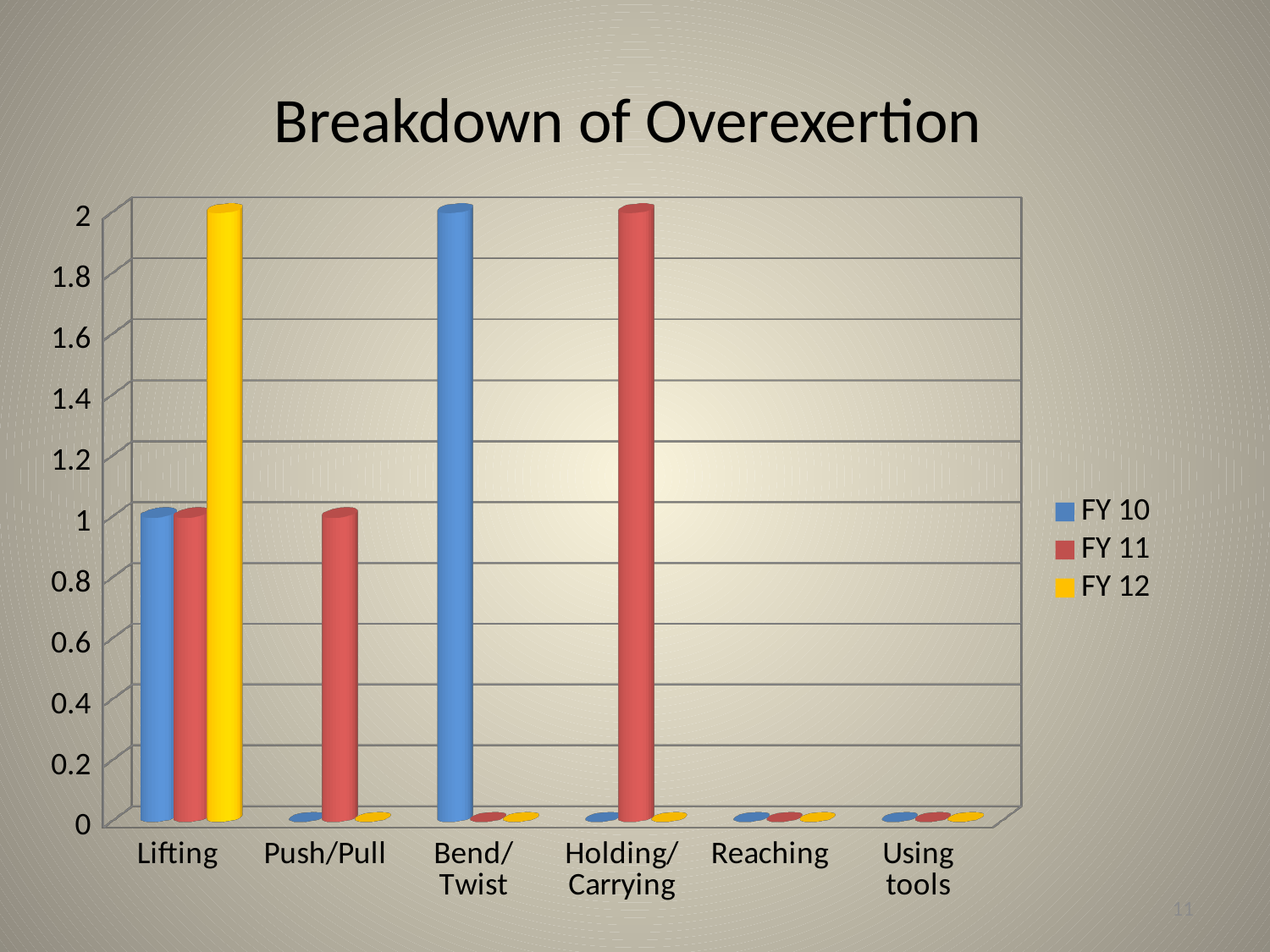
How many categories are shown on the x axis? 6 Which is larger, the FY 11 value for Holding/Carrying or the FY 11 value for Push/Pull? Holding/Carrying What is the FY 10 value for Reaching? 0 Which category has the highest FY 12 value? Lifting How many series does the legend list? 3 What is the FY 10 value for Bend/Twist? 2 What is the FY 11 value for Push/Pull? 1 What is the difference between the FY 12 and FY 10 values for Lifting? 1 What is the title of the chart? Breakdown of Overexertion What kind of chart is shown on the slide? bar chart What is the FY 11 value for Holding/Carrying? 2 What is the FY 12 value for Lifting? 2